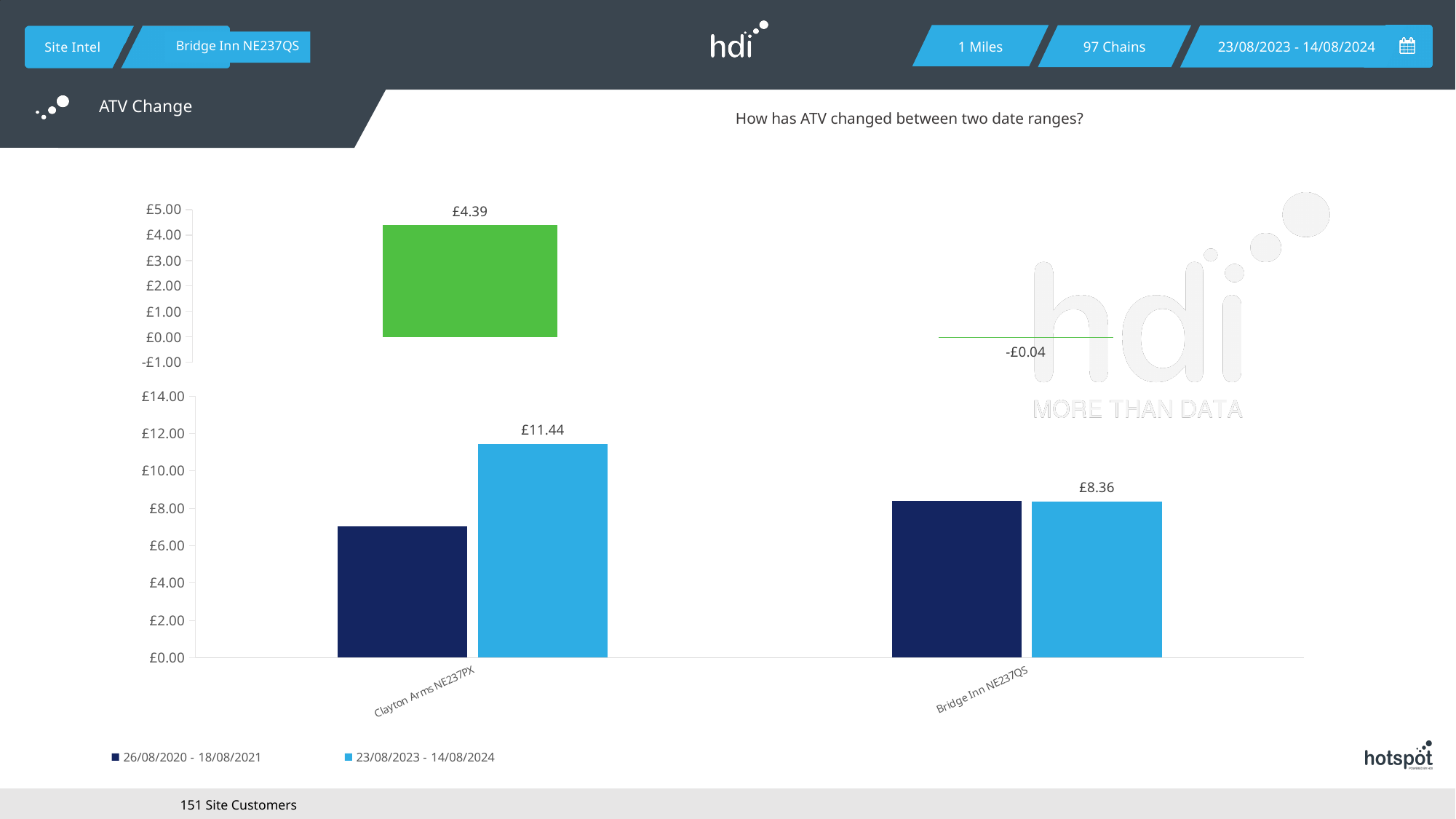
In the bottom chart, is the 26/08/2020 - 18/08/2021 value for Clayton Arms NE237PX greater or less than £8.00? less How many series does the legend of the bottom chart list? 2 In the top chart, what is the ATV change value for Clayton Arms NE237PX? £4.39 In the top chart, what is the ATV change value for Bridge Inn NE237QS? -£0.04 In the bottom chart, is the 26/08/2020 - 18/08/2021 value for Bridge Inn NE237QS greater or less than £6.00? greater In the bottom chart, what is the difference between the 23/08/2023 - 14/08/2024 values for Clayton Arms NE237PX and Bridge Inn NE237QS? £3.08 In the bottom chart, what is the value for Clayton Arms NE237PX in the 23/08/2023 - 14/08/2024 series? £11.44 What type of chart is the bottom chart? bar chart How many sites are shown on the x axis of the bottom chart? 2 In the bottom chart, which is larger for Clayton Arms NE237PX: the 26/08/2020 - 18/08/2021 bar or the 23/08/2023 - 14/08/2024 bar? 23/08/2023 - 14/08/2024 In the top chart, which site has the higher ATV change? Clayton Arms NE237PX In the bottom chart, what is the value for Bridge Inn NE237QS in the 23/08/2023 - 14/08/2024 series? £8.36